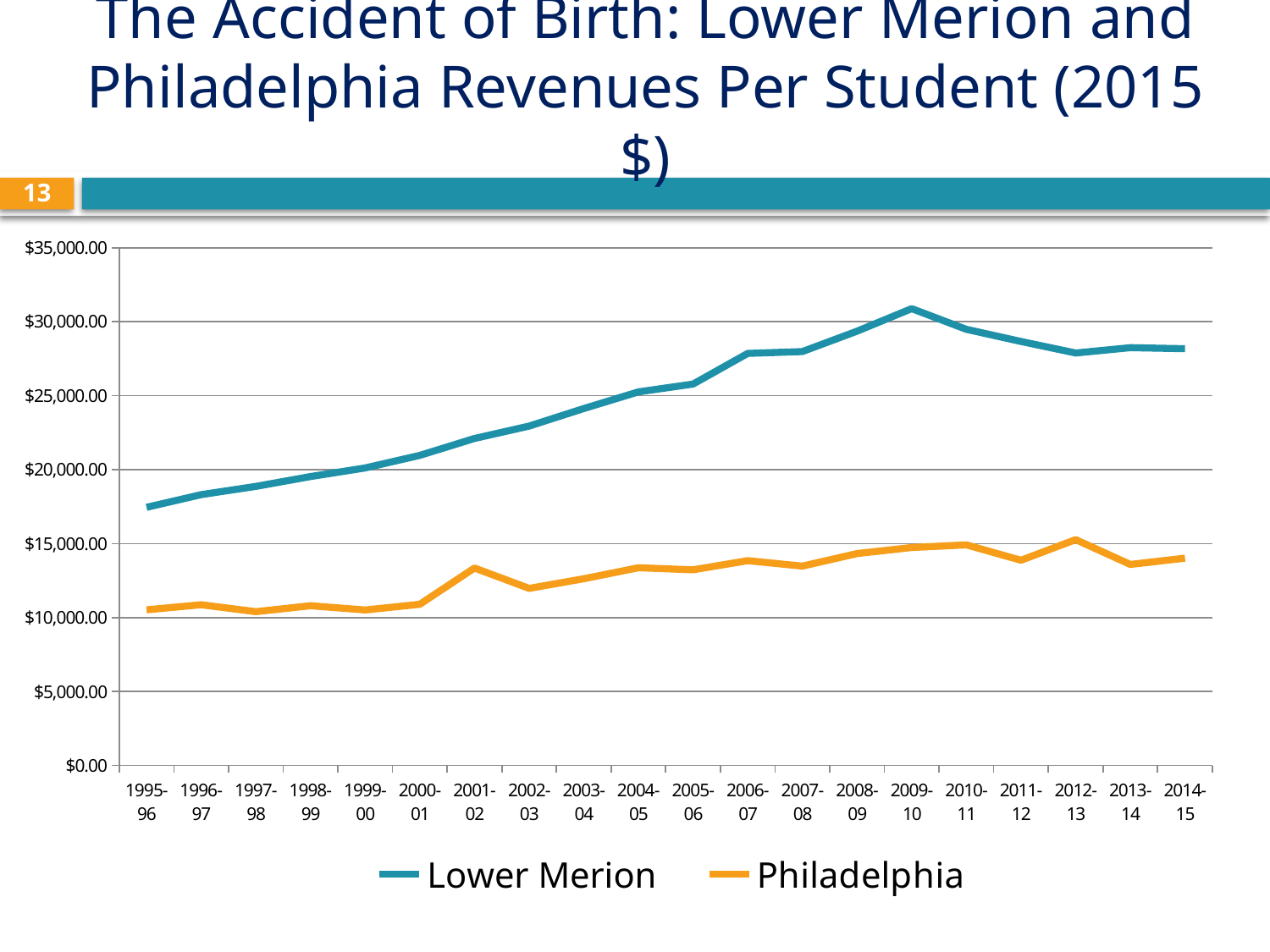
Is the Lower Merion value for 2009-10 greater or less than $30,000.00? greater How many school years are plotted along the x axis? 20 Which colour is used for the Philadelphia line? Orange How many series does the legend list? 2 Is the Lower Merion value for 1995-96 greater or less than $20,000.00? less Does the Lower Merion line rise or fall from 1995-96 to 2009-10? Rise Is the Philadelphia value for 2001-02 greater or less than $10,000.00? greater What kind of chart is shown on the slide? Line chart In which school year does the Lower Merion line reach its highest value? 2009-10 In which school year is the Lower Merion value lowest? 1995-96 Which series has the higher value in 2014-15, Lower Merion or Philadelphia? Lower Merion